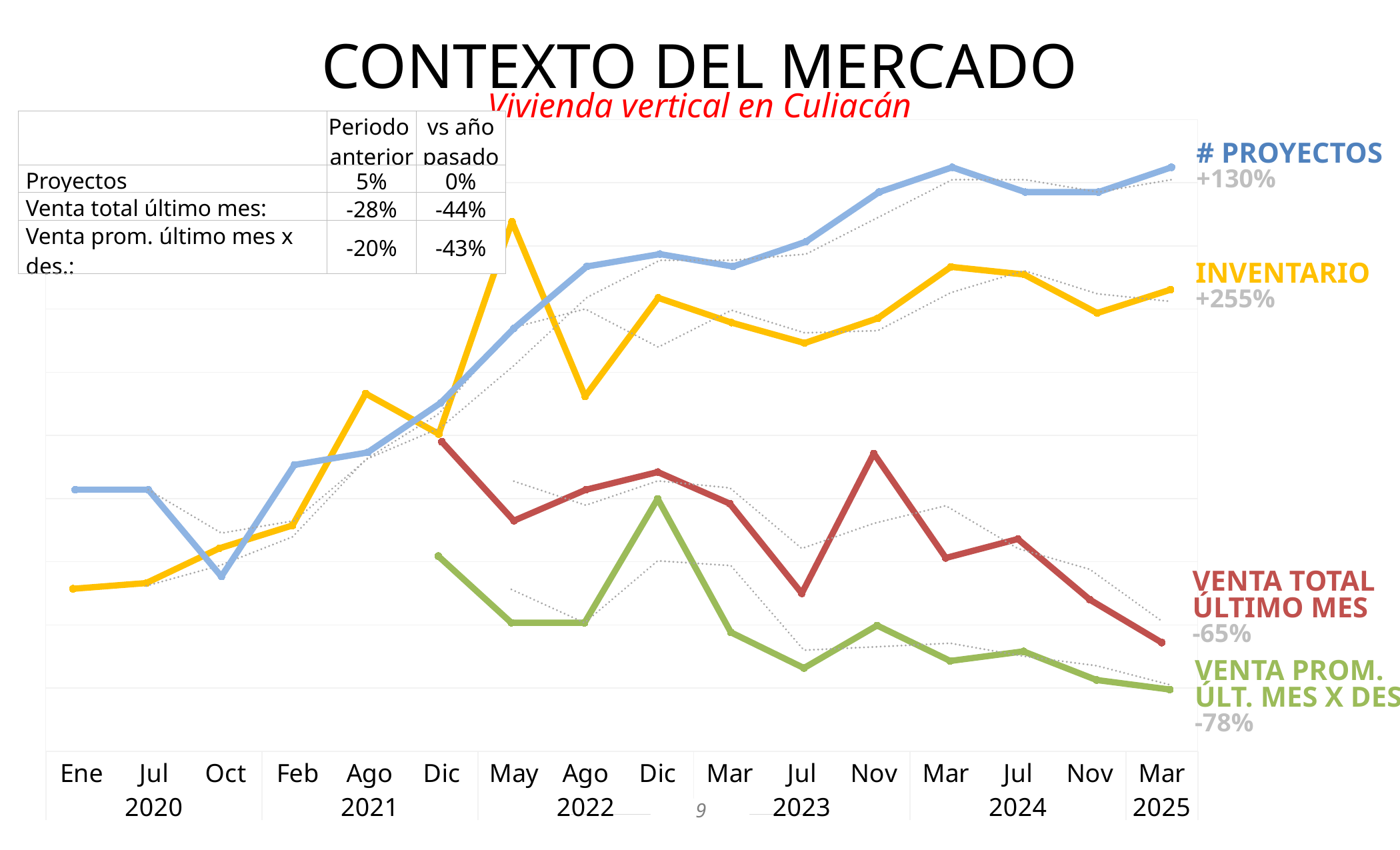
At Mar 2025, which is higher: INVENTARIO or VENTA TOTAL ÚLTIMO MES? INVENTARIO What percentage change is printed next to the INVENTARIO series? +255% What kind of chart is shown on the slide? line chart What percentage change is printed next to the VENTA TOTAL ÚLTIMO MES series? -65% How many points are labelled along the x axis of the chart? 16 Which series has the lowest value at Mar 2025? VENTA PROM. ÚLT. MES X DES. Which series is drawn in blue? # PROYECTOS How many series are labelled on the chart? 4 Does the VENTA TOTAL ÚLTIMO MES series rise or fall from Nov 2023 to Mar 2025? fall What percentage change is printed next to the # PROYECTOS series? +130% What percentage change is printed next to the VENTA PROM. ÚLT. MES X DES. series? -78%